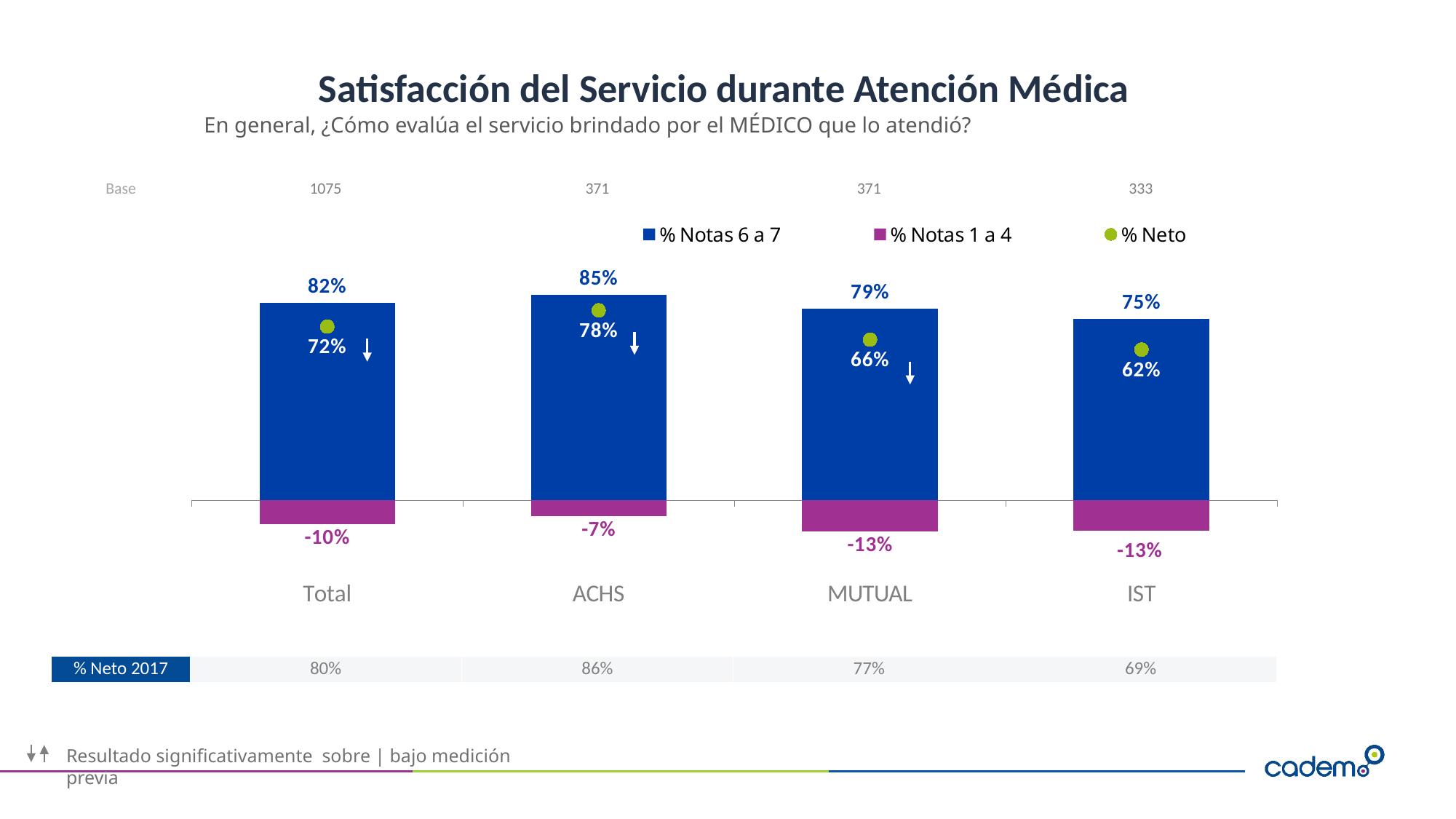
What is the % Notas 6 a 7 value for ACHS? 85% What is the % Notas 1 a 4 value for MUTUAL? -13% What is the % Neto 2017 value shown for MUTUAL in the row below the chart? 77% What kind of chart is shown on the slide? Bar chart Which category has the highest % Notas 6 a 7 value? ACHS How many series does the legend list? 3 What is the difference between the % Notas 6 a 7 values for ACHS and IST? 10% Which is larger, the % Neto for ACHS or the % Neto for MUTUAL? ACHS Which category has the lowest % Neto value? IST What is the % Neto value for Total? 72% What is the % Neto value for IST? 62% How many categories are shown on the x axis? 4